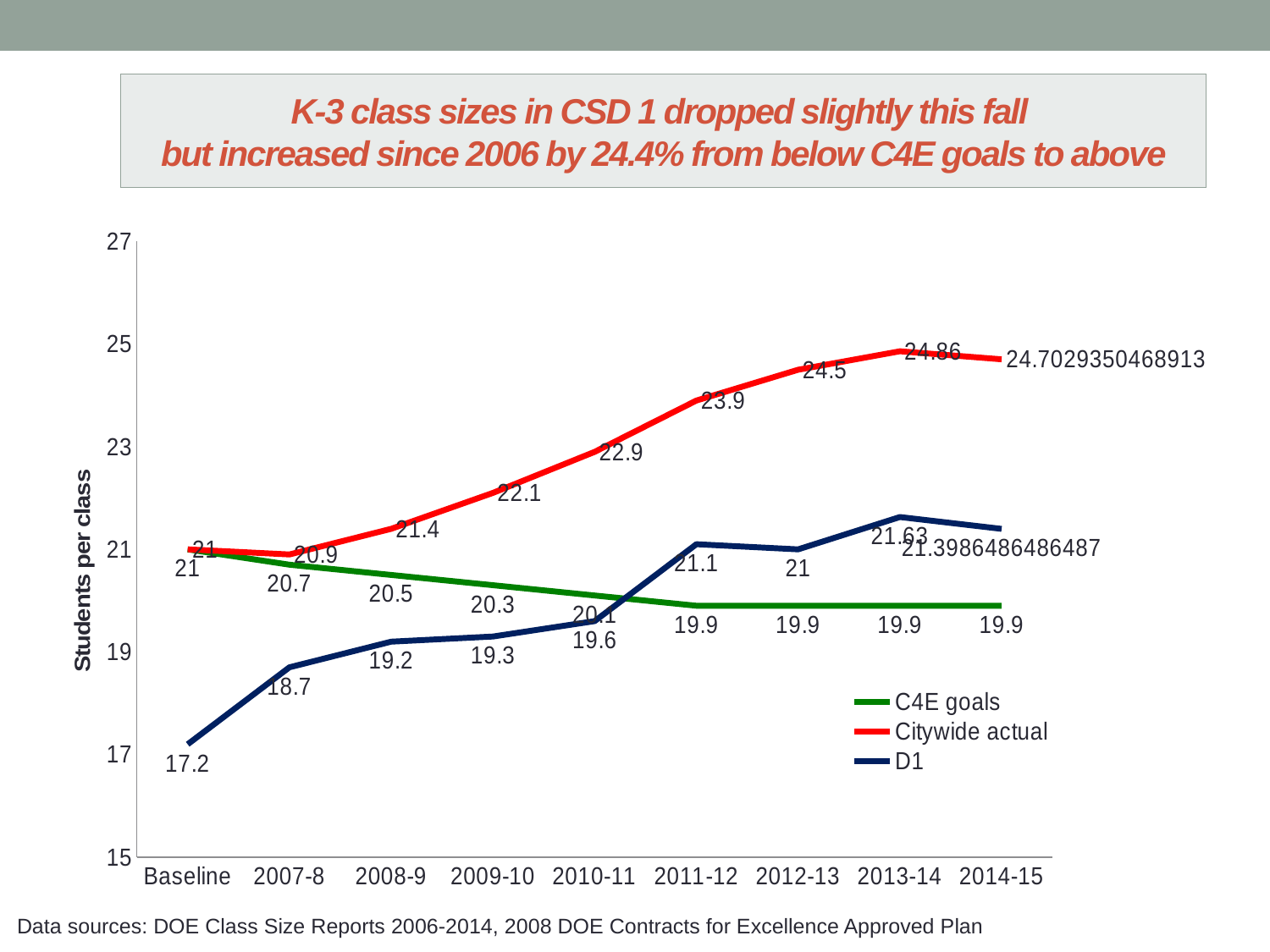
What is the C4E goals value for 2014-15? 19.9 What is the title of the y axis? Students per class How many series does the legend list? 3 Does the C4E goals series rise or fall from Baseline to 2014-15? fall At which x-axis point is the D1 series lowest? Baseline What is the Citywide actual value for 2012-13? 24.5 In which year does the Citywide actual series reach its highest value? 2013-14 What is the difference between the Citywide actual value and the D1 value in 2013-14? 3.23 In 2011-12, which is larger: the D1 value or the C4E goals value? D1 How many points are plotted along the x axis for each series? 9 What is the D1 value at Baseline? 17.2 What kind of chart is shown on the slide? line chart